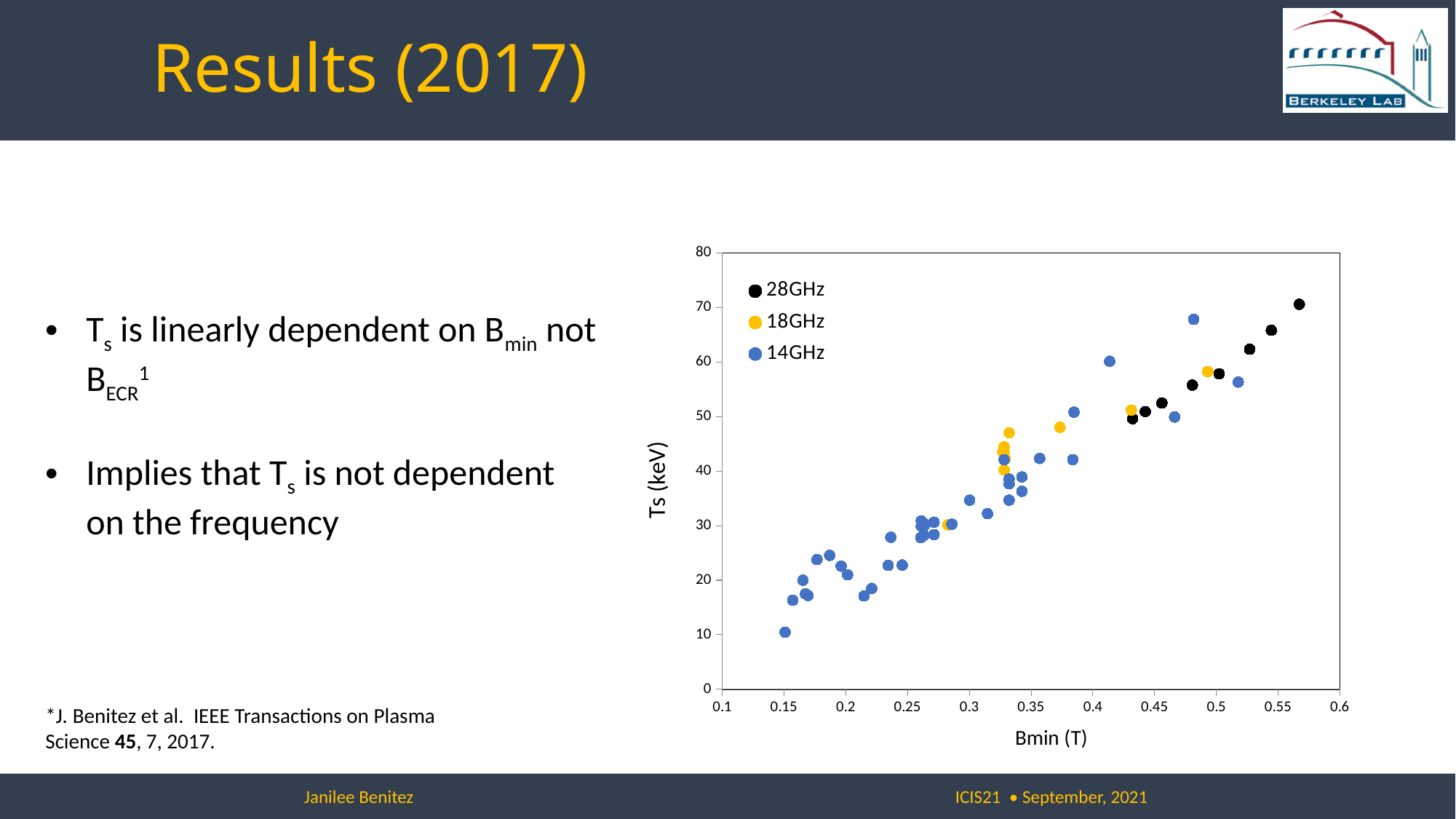
Is the highest Ts value for the 14GHz series greater or less than 60? greater Which series contains the point with the highest Ts value? 28GHz What are the three series named in the legend? 28GHz, 18GHz, 14GHz Does Ts rise or fall as Bmin increases along the x axis? rise What kind of chart is shown on the slide? scatter chart Is the highest Ts value for the 18GHz series greater or less than 50? greater Is the lowest Ts value for the 28GHz series greater or less than 40? greater Which series has a higher maximum Ts value, 18GHz or 28GHz? 28GHz What is the label of the y axis? Ts (keV) How many series does the legend list? 3 Which series contains the point with the lowest Ts value? 14GHz